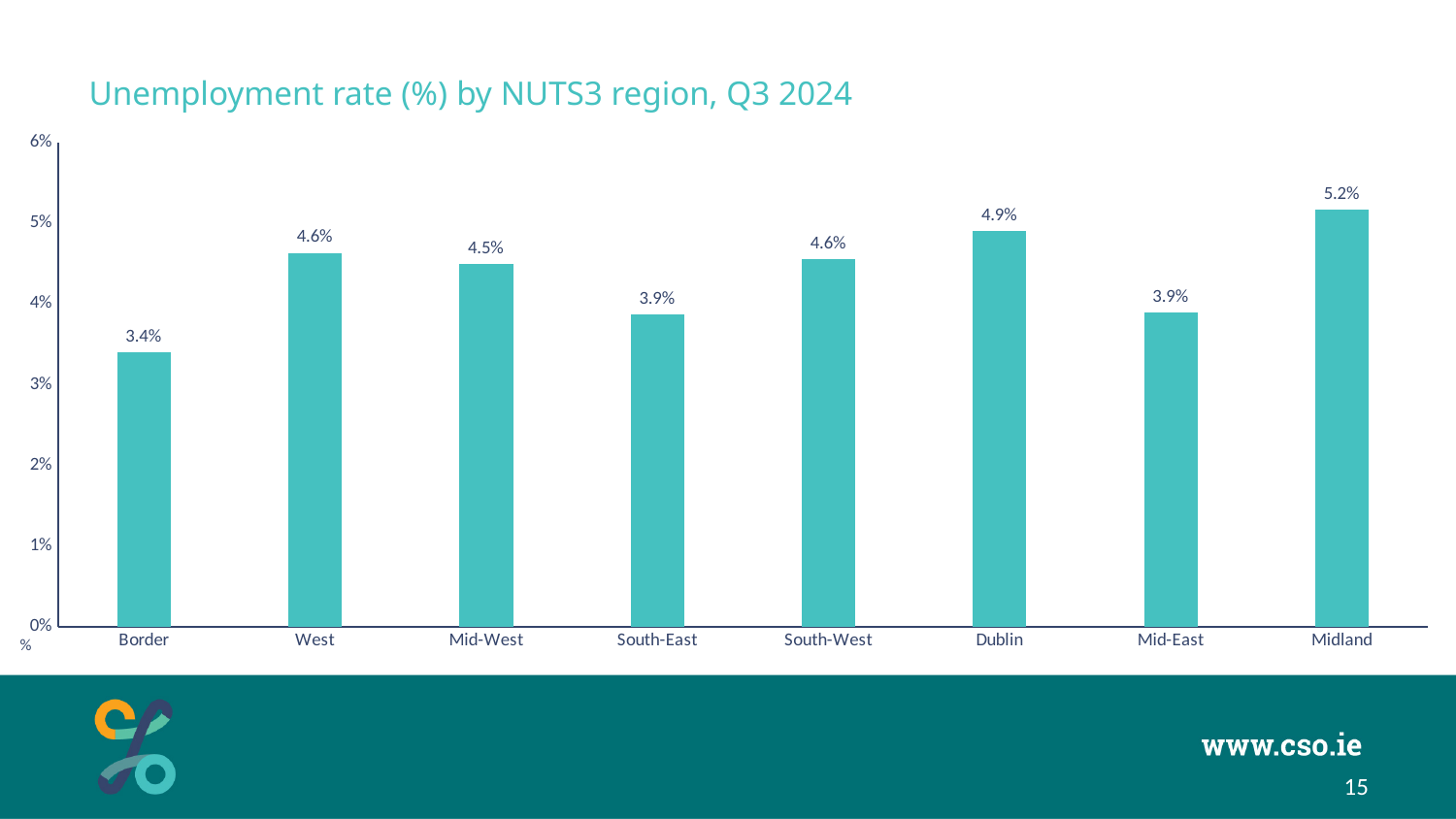
What is the difference in unemployment rate between Dublin and South-East? 1.0% Which region has the lowest unemployment rate? Border What is the title of the chart? Unemployment rate (%) by NUTS3 region, Q3 2024 What is the difference in unemployment rate between Midland and Border? 1.8% Which region has the highest unemployment rate? Midland Which has a higher unemployment rate, West or Mid-East? West What is the unemployment rate for the Mid-West region? 4.5% What is the unemployment rate for Dublin? 4.9% What kind of chart is shown on the slide? Bar chart How many regions are shown on the chart? 8 What is the unemployment rate for the Border region? 3.4% Is the unemployment rate for South-West greater or less than 4%? greater